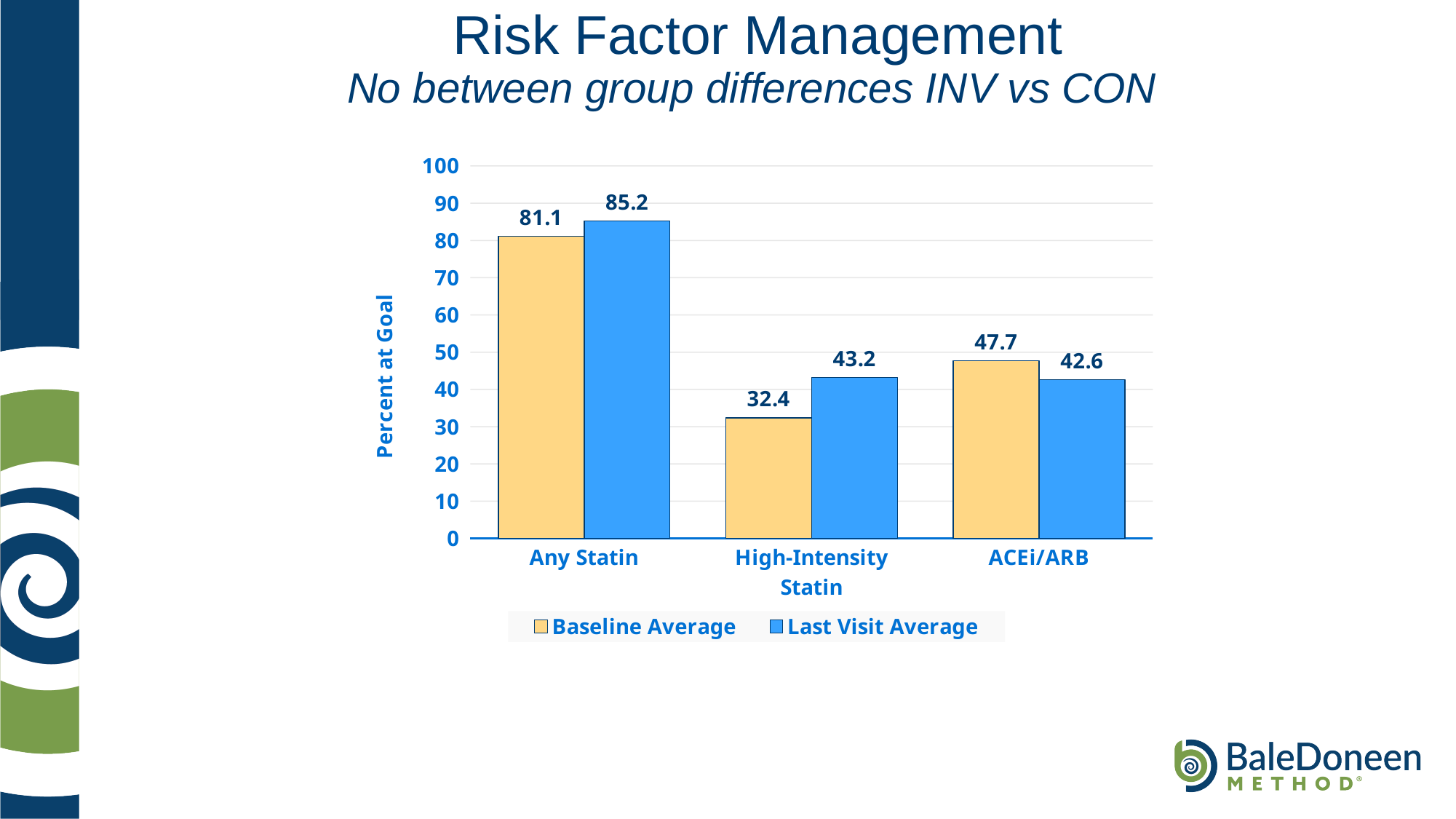
What is the label of the y axis? Percent at Goal What kind of chart is shown on the slide? bar chart Which category has the highest Last Visit Average value? Any Statin How many series does the legend list? 2 How many categories are shown on the x axis? 3 Is the Last Visit Average value for Any Statin greater or less than 80? greater What is the Baseline Average value for Any Statin? 81.1 What is the difference between the Last Visit Average and Baseline Average for High-Intensity Statin? 10.8 What is the Baseline Average value for ACEi/ARB? 47.7 Which category has the lowest Baseline Average value? High-Intensity Statin For ACEi/ARB, which is larger: the Baseline Average or the Last Visit Average? Baseline Average What is the Last Visit Average value for High-Intensity Statin? 43.2